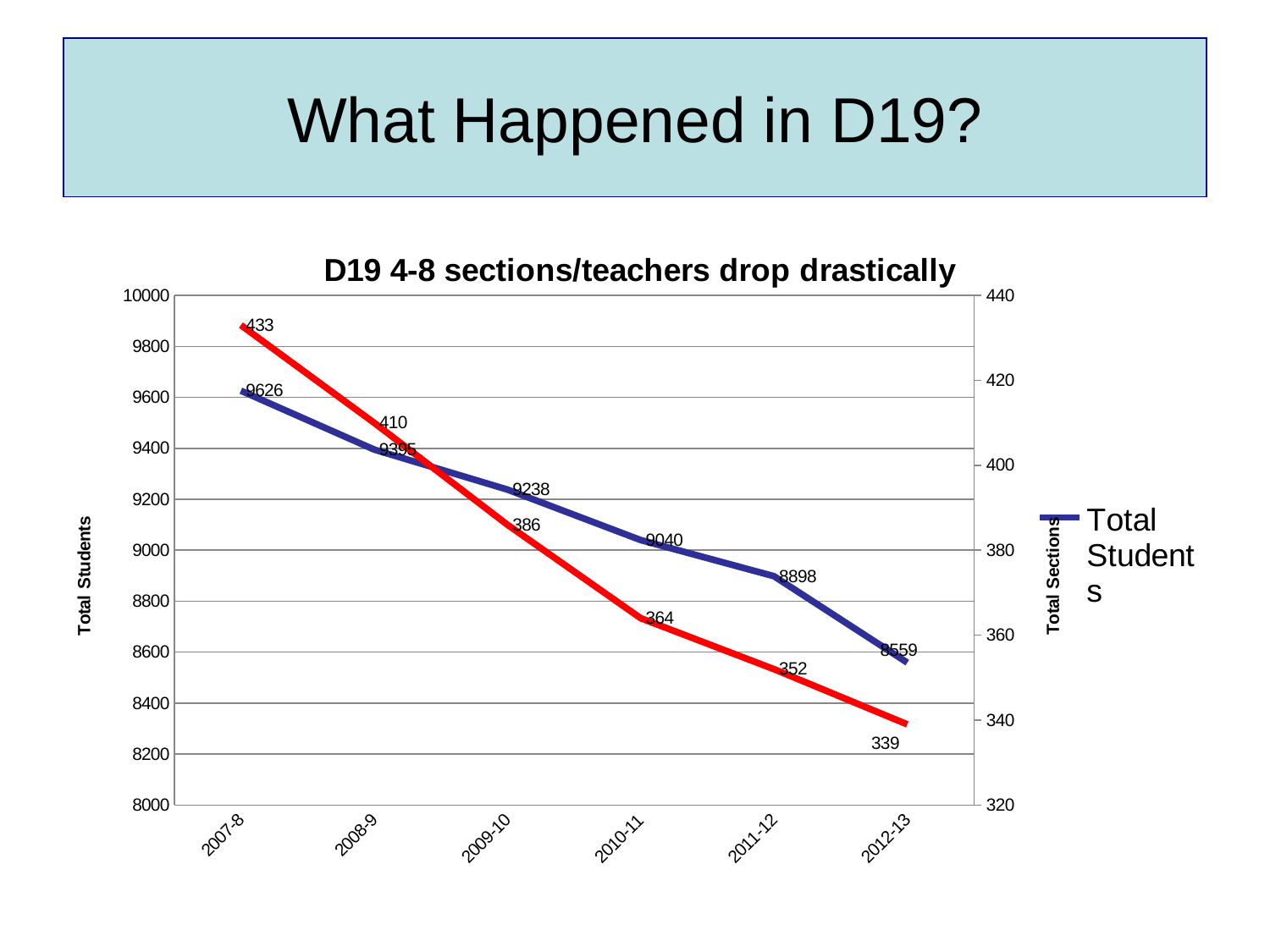
What is the chart's title? D19 4-8 sections/teachers drop drastically What is the value of the red Total Sections line for 2009-10? 386 In which school year is the red Total Sections line lowest? 2012-13 What is the difference in Total Students between 2007-8 and 2012-13? 1067 In which school year is Total Students highest? 2007-8 What is the value of the red Total Sections line for 2012-13? 339 How many school years are plotted along the x axis? 6 What is the Total Students value for 2007-8? 9626 Does Total Students rise or fall from 2007-8 to 2012-13? fall What is the Total Students value for 2012-13? 8559 What is the difference in Total Sections between 2007-8 (433) and 2008-9 (410)? 23 What type of chart is shown on the slide? line chart